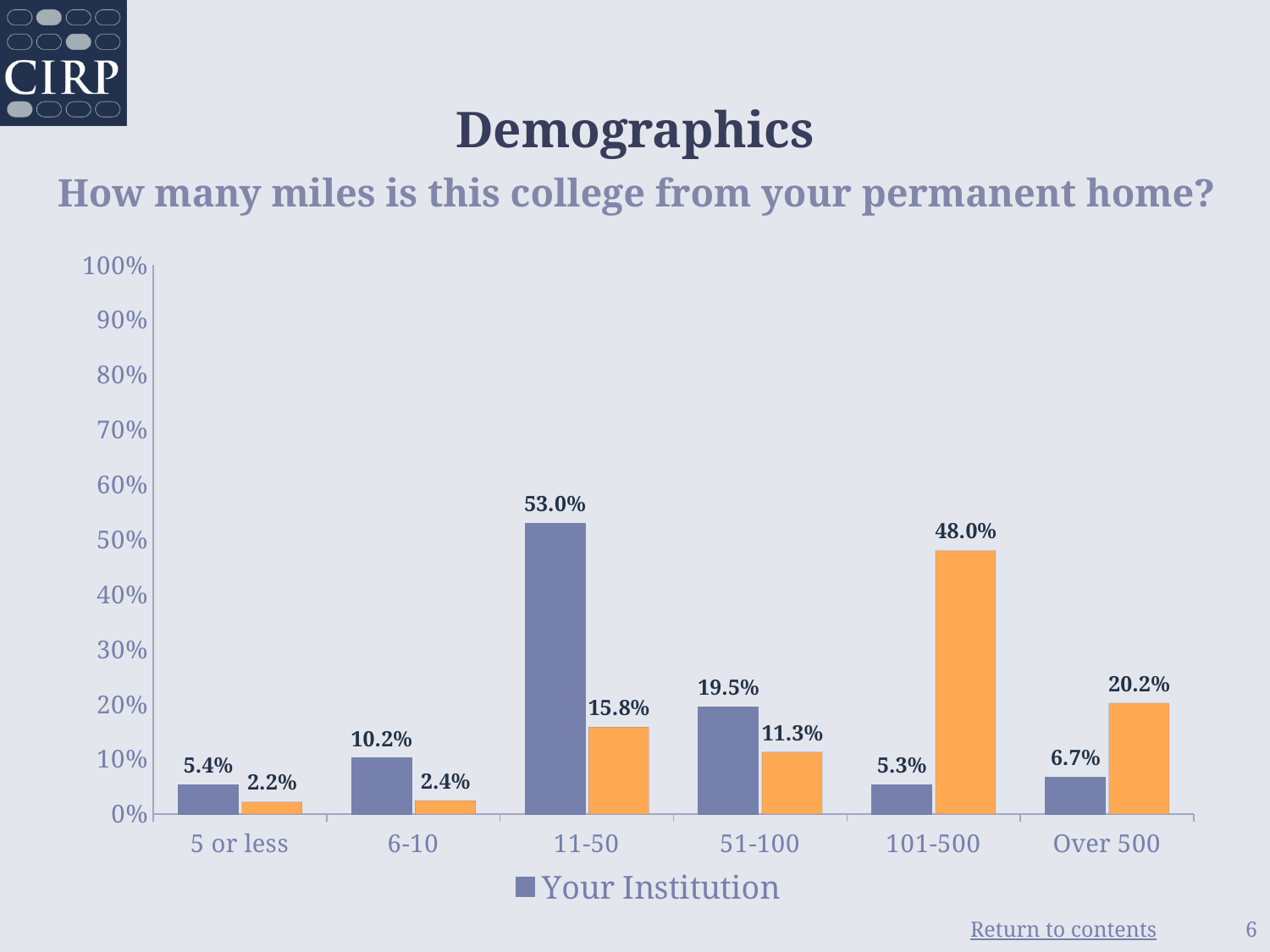
What is the value for Your Institution in the 11-50 category? 53.0% Which category has the highest value for Your Institution? 11-50 What kind of chart is shown on the slide? Bar chart What is the difference between the Your Institution value and the orange bar value in the 11-50 category? 37.2% How many series does the legend list? 1 Is the orange bar value for 101-500 greater or less than 40%? greater Which category has the lowest value for the orange bars? 5 or less How many categories are shown on the x axis? 6 What is the value for Your Institution in the Over 500 category? 6.7% In the 51-100 category, which is larger: the Your Institution bar or the orange bar? Your Institution What is the question shown as the chart's subtitle? How many miles is this college from your permanent home? What is the value of the orange bar for the 101-500 category? 48.0%